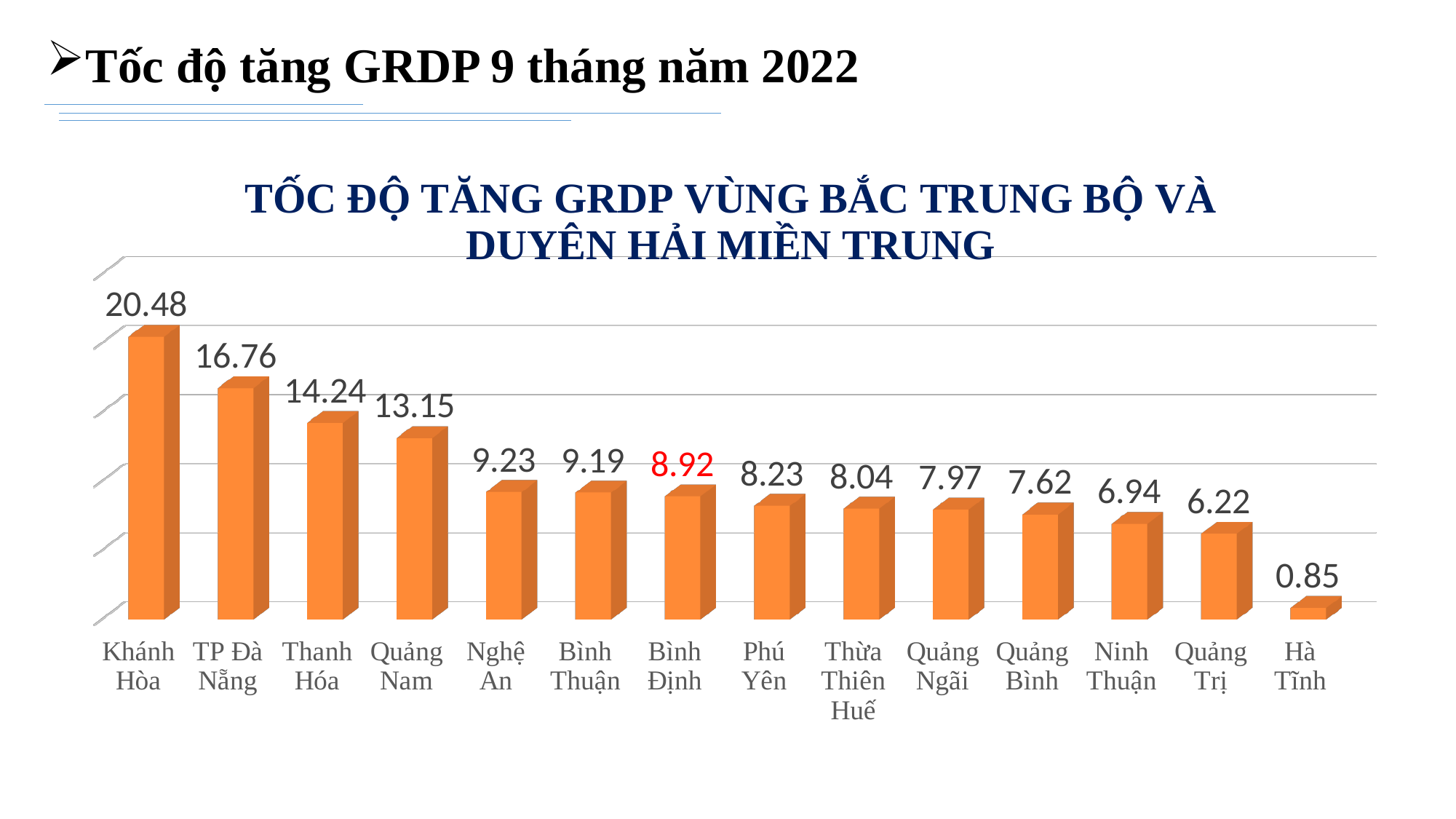
What is the GRDP growth rate shown for Khánh Hòa? 20.48 Which is larger, the value for Quảng Nam or the value for Nghệ An? Quảng Nam How many provinces are shown in the chart? 14 Do the values rise or fall from left to right along the x axis? Fall Which province has the highest GRDP growth rate in the chart? Khánh Hòa Which province has the lowest GRDP growth rate in the chart? Hà Tĩnh What value is shown for Thừa Thiên Huế? 8.04 What kind of chart is shown on the slide? Bar chart What value is shown for Bình Định? 8.92 What value is shown for Ninh Thuận? 6.94 What is the difference between the values for Khánh Hòa and TP Đà Nẵng? 3.72 What is the difference between the values for Quảng Trị and Hà Tĩnh? 5.37